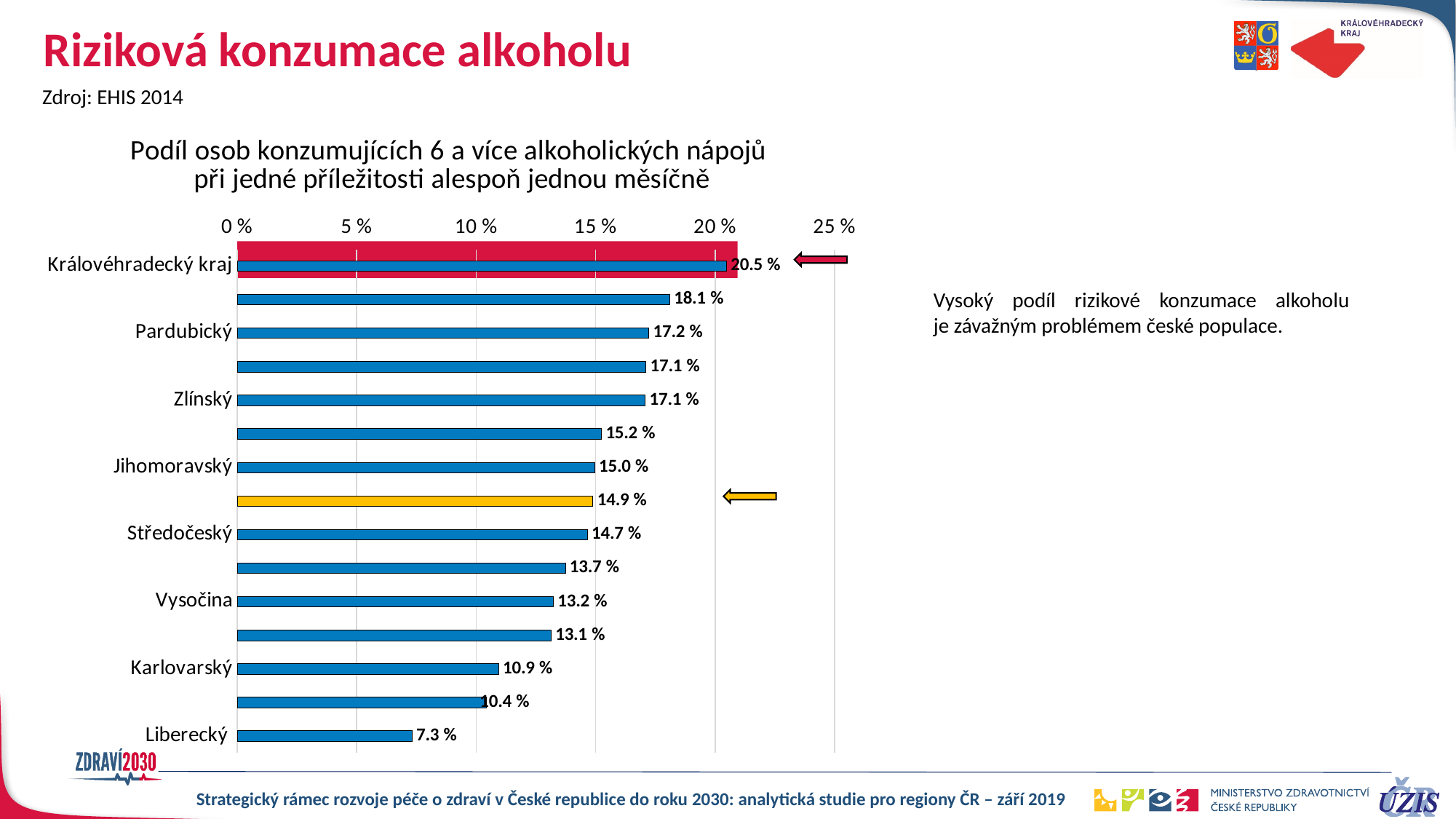
Which is larger, the value for Jihomoravský or the value for Vysočina? Jihomoravský What is the difference between the values for Královéhradecký kraj and Liberecký? 13.2 % How many bars are plotted in the chart? 15 What is the difference between the values for Pardubický and Zlínský? 0.1 % What is the value for Liberecký? 7.3 % What is the value for Královéhradecký kraj? 20.5 % What is the value for Pardubický? 17.2 % What kind of chart is shown on the slide? Bar chart What is the value for Karlovarský? 10.9 % Which category has the highest value? Královéhradecký kraj Which category has the lowest value? Liberecký What value is shown on the yellow bar? 14.9 %